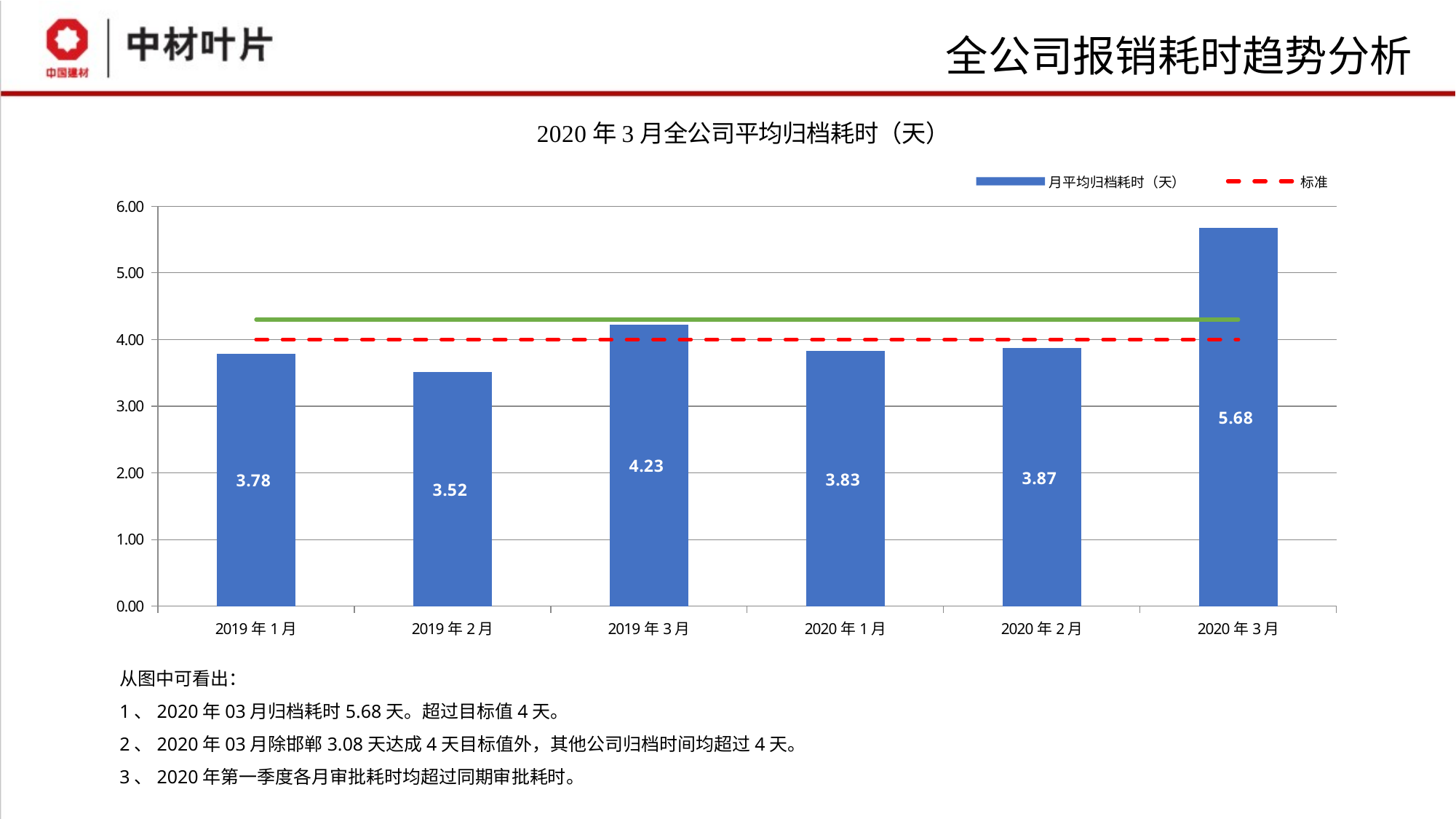
What is the value for 2020年3月? 5.68 Which month has the lowest value? 2019年2月 How many series does the legend list? 2 Is the value for 2020年2月 greater or less than 4.00? less What is the title of the chart? 2020年3月全公司平均归档耗时（天） What is the value for 2019年1月? 3.78 What kind of chart is this? combination bar and line chart Which is larger, the value for 2019年3月 or the value for 2020年1月? 2019年3月 Which month has the highest value? 2020年3月 How many months are shown on the x axis? 6 What is the difference between the values for 2020年3月 and 2020年2月? 1.81 What is the value for 2019年3月? 4.23